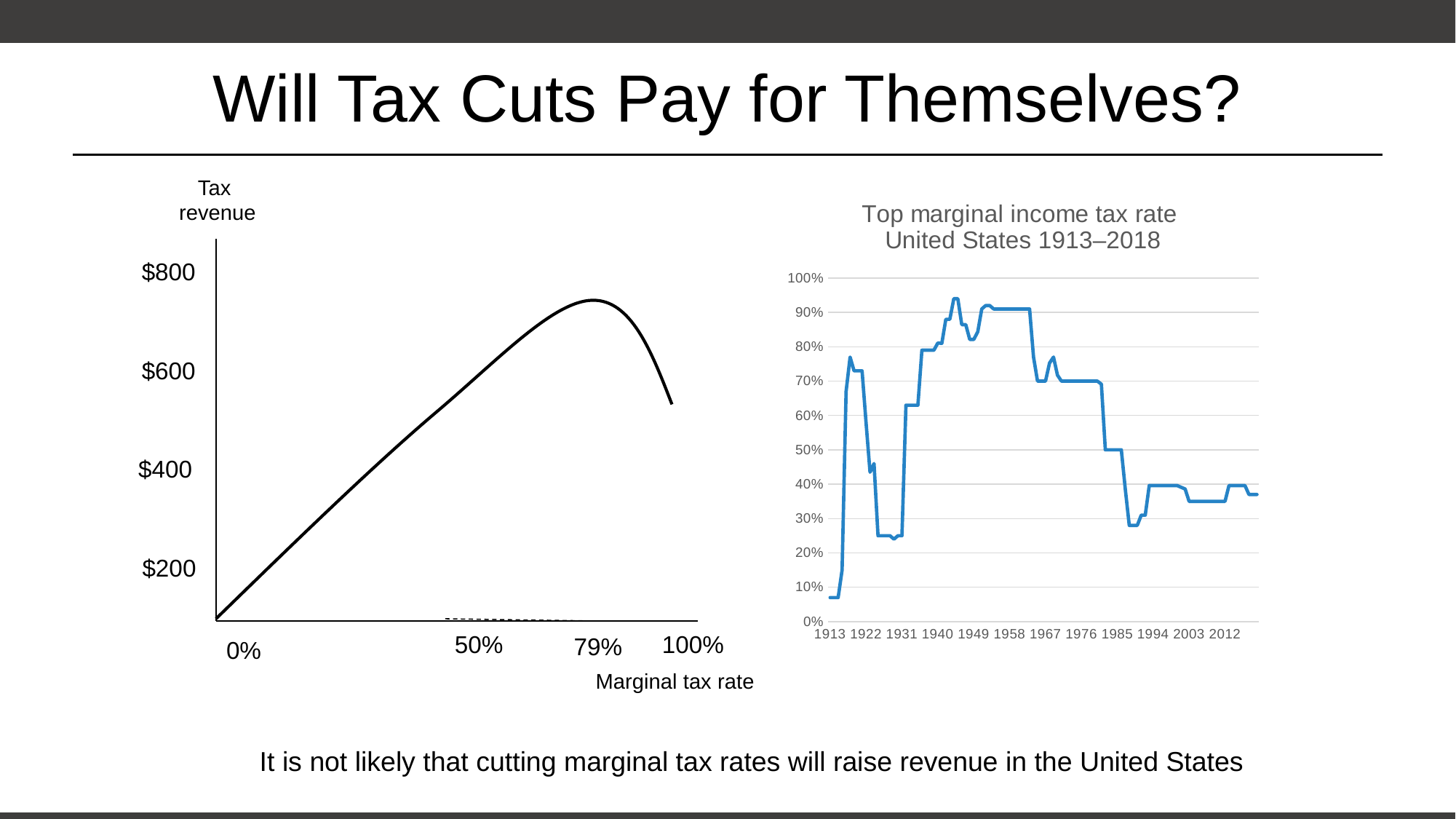
In the left-hand chart of tax revenue against marginal tax rate, at which marginal tax rate does the curve reach its peak? 79% In the right-hand chart, is the top marginal income tax rate in 2012 greater or less than 50%? less What is the x-axis label of the left-hand chart? Marginal tax rate In the left-hand chart, is the tax revenue at the right end of the curve (near 100%) greater or less than $600? less What kind of chart is the right-hand chart titled 'Top marginal income tax rate United States 1913–2018'? line chart In the right-hand chart, is the top marginal income tax rate in 1958 greater or less than 80%? greater How many year labels are shown on the x axis of the right-hand chart? 12 In the left-hand chart, does tax revenue rise or fall as the marginal tax rate increases from 0% to 79%? rise In the right-hand chart, does the top marginal income tax rate rise or fall overall between 1958 and 2012? fall